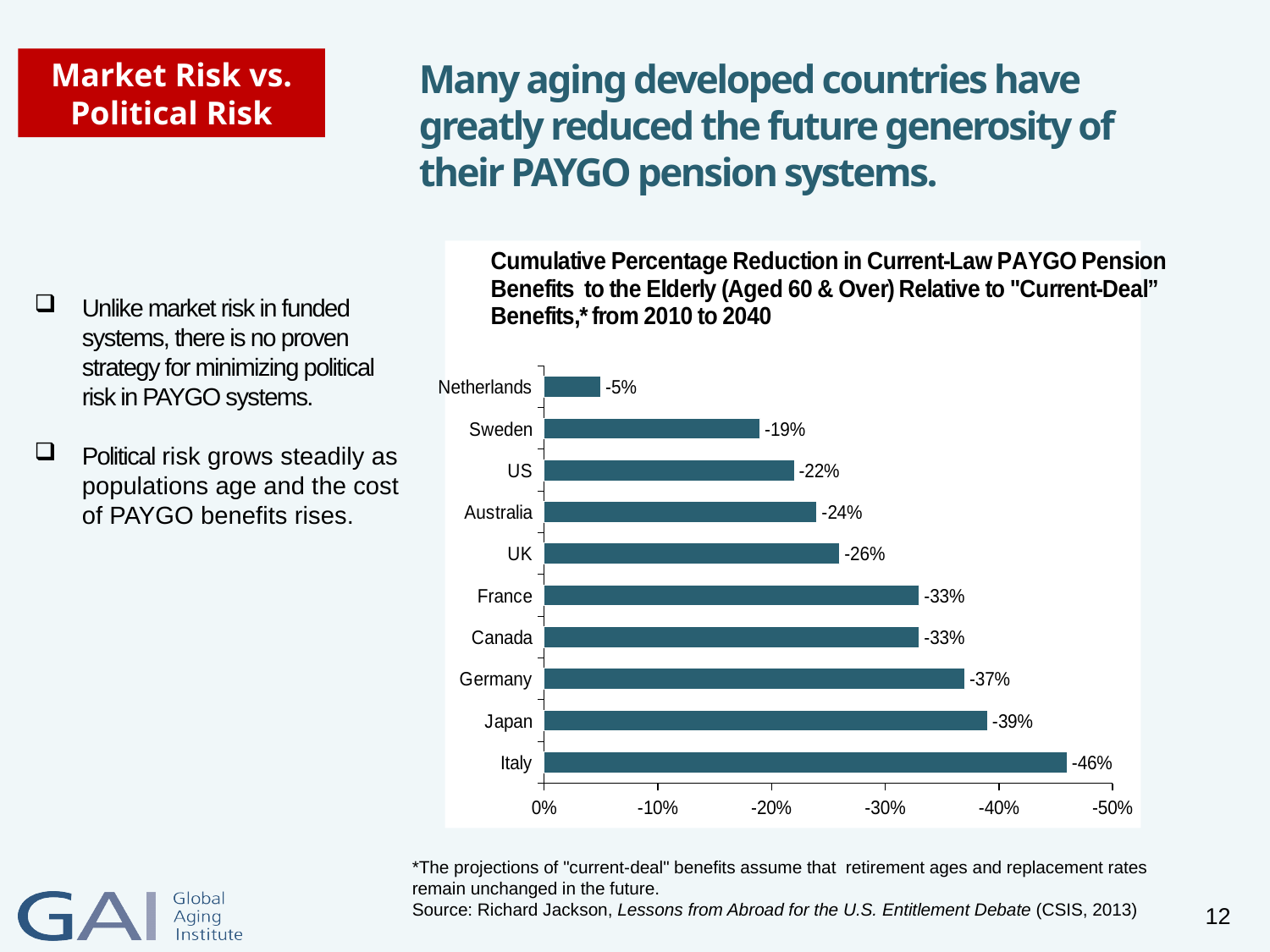
How many countries are shown in the chart? 10 What kind of chart is shown on the slide? Bar chart What is the value shown for the Netherlands? -5% What is the value shown for the US? -22% Which two countries share the same value of -33%? France and Canada Which country shows a larger reduction, the UK or Australia? UK What is the difference in percentage points between the values for Japan and Sweden? 20 percentage points Which country has the smallest cumulative percentage reduction? Netherlands What time period does the chart title say the reductions cover? From 2010 to 2040 Which country has the largest cumulative percentage reduction? Italy What is the value shown for Germany? -37% What is the value shown for Italy? -46%